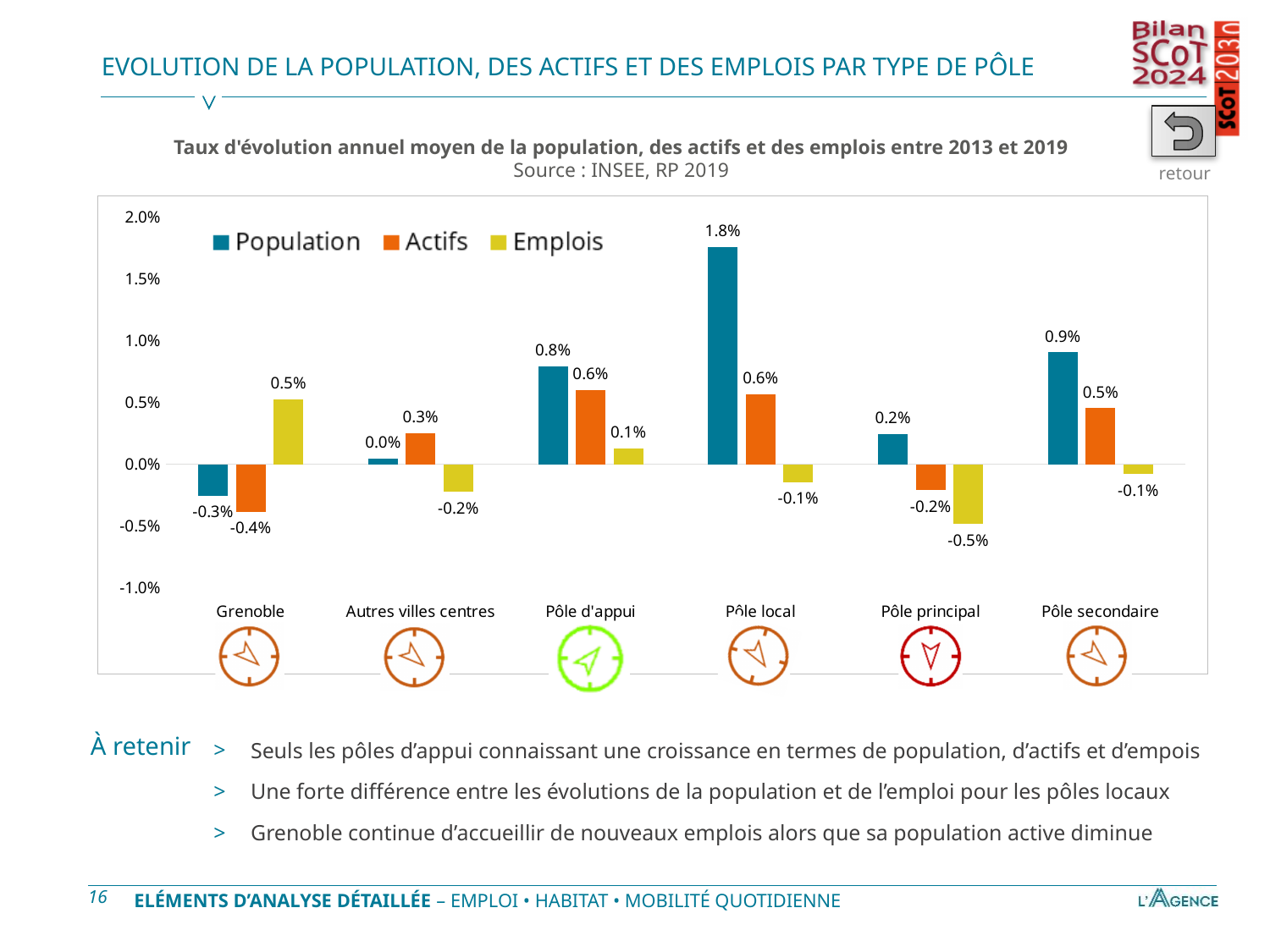
Which category has the lowest Emplois value? Pôle principal How many series does the legend list? 3 What is the Population value for Autres villes centres? 0.0% What is the difference between the Population and Emplois values for Pôle local? 1.9 percentage points Which category has the highest Population value? Pôle local What is the Emplois value for Grenoble? 0.5% What source is cited under the chart title? INSEE, RP 2019 What is the Actifs value for Pôle principal? -0.2% What kind of chart is shown on the slide? Bar chart What is the Population value for Pôle local? 1.8% Which is larger for Pôle secondaire, the Population value or the Actifs value? Population How many categories are shown on the x axis? 6